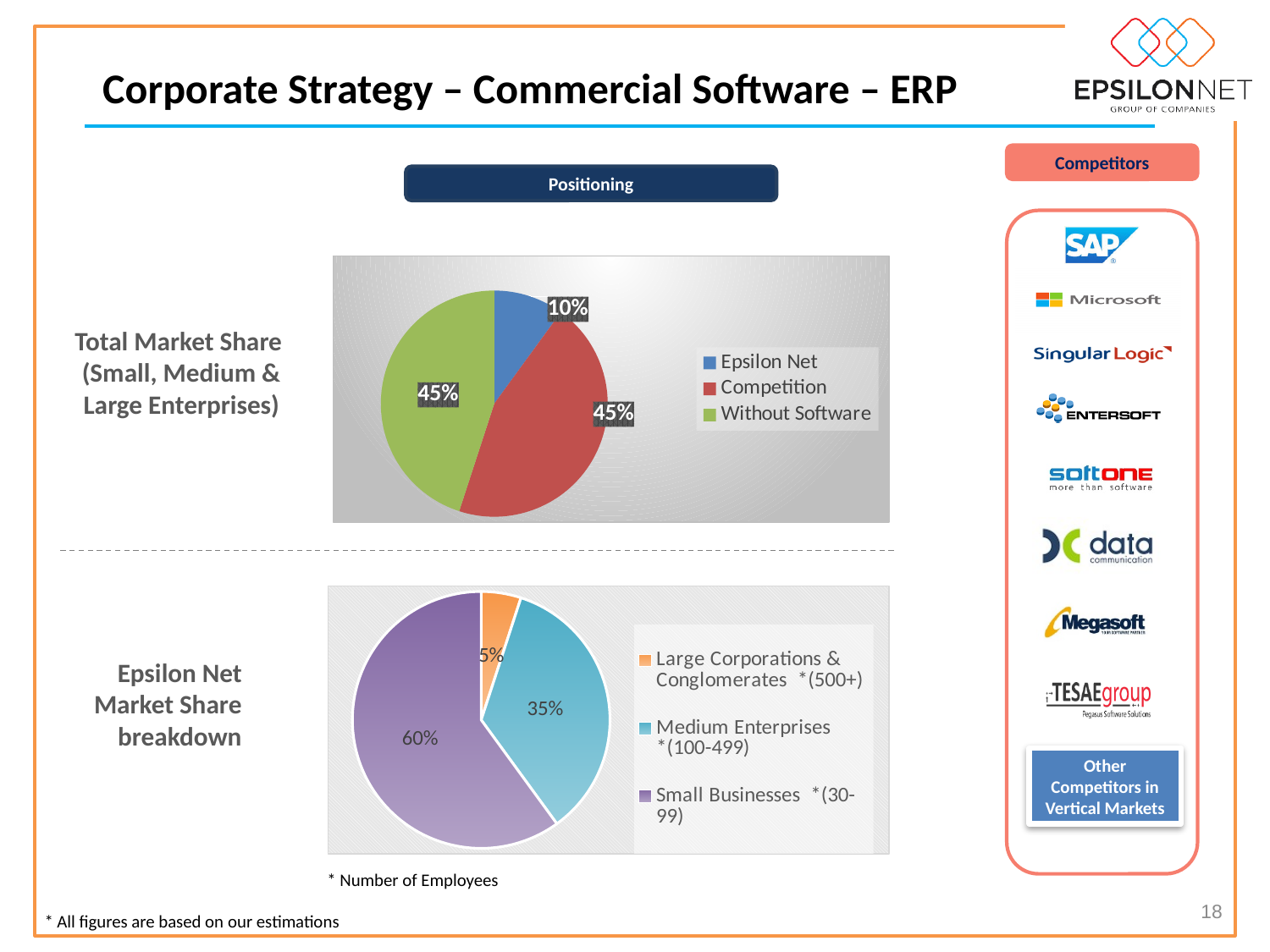
In the Epsilon Net Market Share breakdown chart, which is larger: Medium Enterprises or Large Corporations & Conglomerates? Medium Enterprises In the Total Market Share pie chart, what share does Epsilon Net hold? 10% In the Epsilon Net Market Share breakdown chart, what share do Small Businesses (30-99) account for? 60% In the Total Market Share pie chart, what is the difference between the Competition share and the Epsilon Net share? 35% In the Epsilon Net Market Share breakdown chart, what is the difference between the Small Businesses share and the Medium Enterprises share? 25% In the Epsilon Net Market Share breakdown chart, what share do Medium Enterprises (100-499) account for? 35% What type of chart is used for the Total Market Share? Pie chart In the Total Market Share pie chart, which category has the smallest slice? Epsilon Net How many series does the legend of the Total Market Share pie chart list? 3 In the Epsilon Net Market Share breakdown chart, which category has the smallest slice? Large Corporations & Conglomerates (500+) In the Epsilon Net Market Share breakdown chart, which category has the largest slice? Small Businesses (30-99) In the Total Market Share pie chart, what share is labelled Without Software? 45%